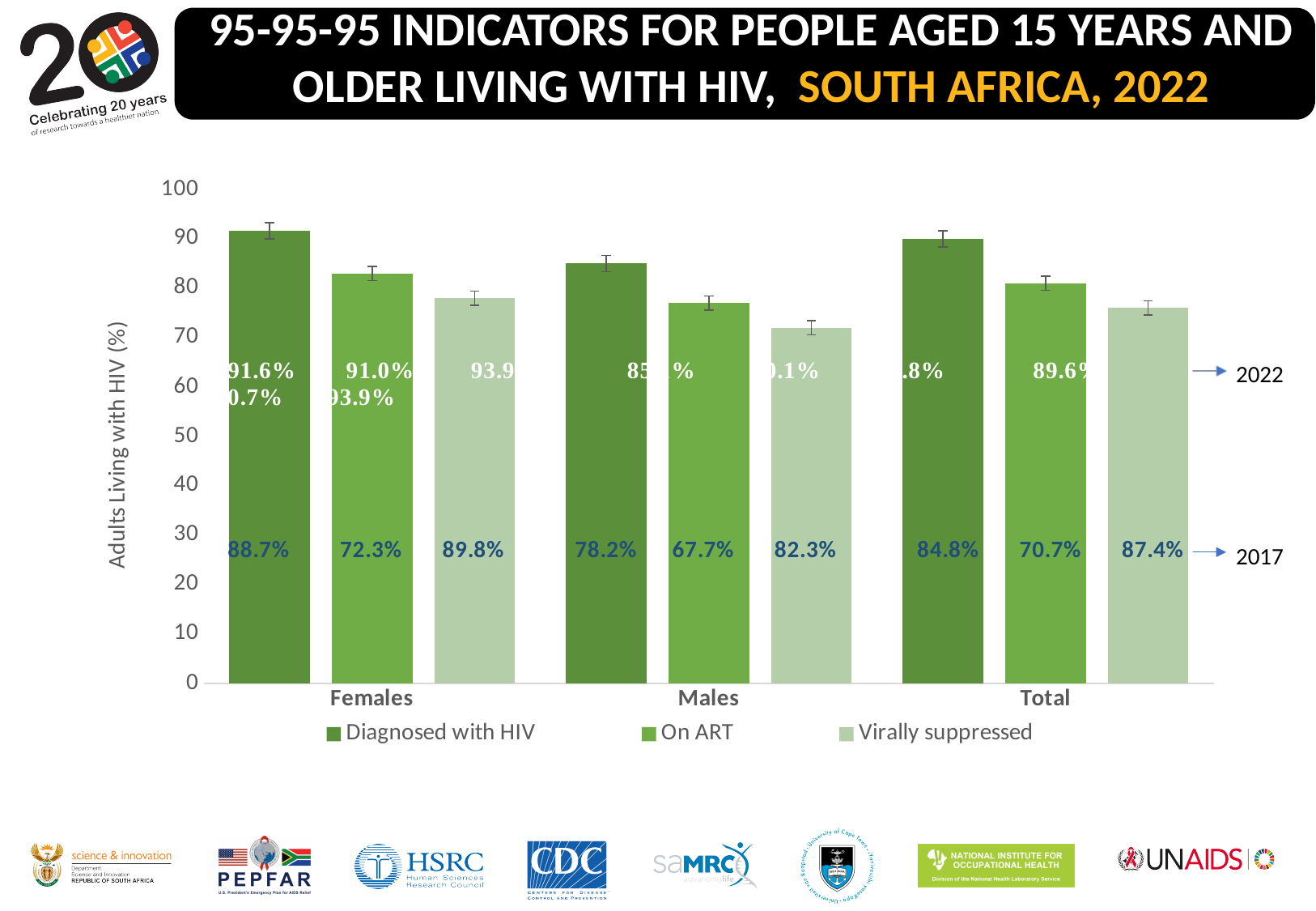
How many series does the legend list? 3 What is the 2017 value for Males Virally suppressed? 82.3% For the 2017 On ART values, which is larger, Females or Males? Females How many categories are shown on the x axis? 3 Is the height of the Virally suppressed bar for Males greater or less than 70? greater What is the title of the y axis? Adults Living with HIV (%) What is the 2017 value for Total Diagnosed with HIV? 84.8% Which 2017 value is the lowest on the chart? Males On ART, 67.7% What kind of chart is shown on the slide? Bar chart Which 2017 value is the highest on the chart? Females Virally suppressed, 89.8% What is the difference between the 2017 Diagnosed with HIV values for Females and Males? 10.5 percentage points What is the 2017 value for Females On ART? 72.3%